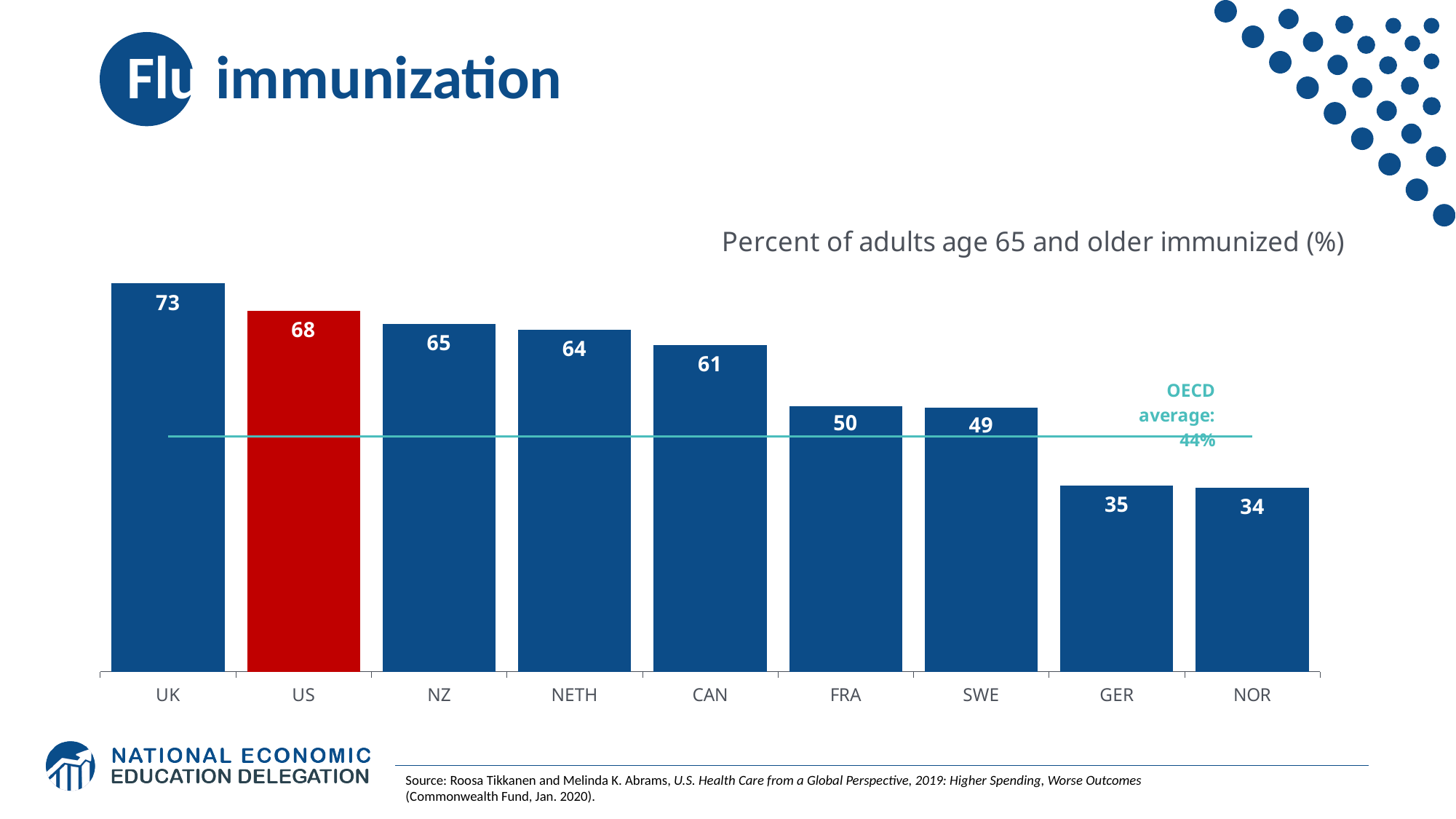
What is the value for CAN? 61 Do the values rise or fall from left to right across the countries? fall What is the value for GER? 35 What OECD average is marked by the horizontal line on the chart? 44% Which is larger, the value for NZ or the value for FRA? NZ What is the difference between the values for UK and US? 5 What kind of chart is shown on the slide? bar chart Which country has the lowest value? NOR Which country has the highest value? UK What is the value for the US? 68 How many countries are shown in the chart? 9 What is the difference between the values for NETH and SWE? 15